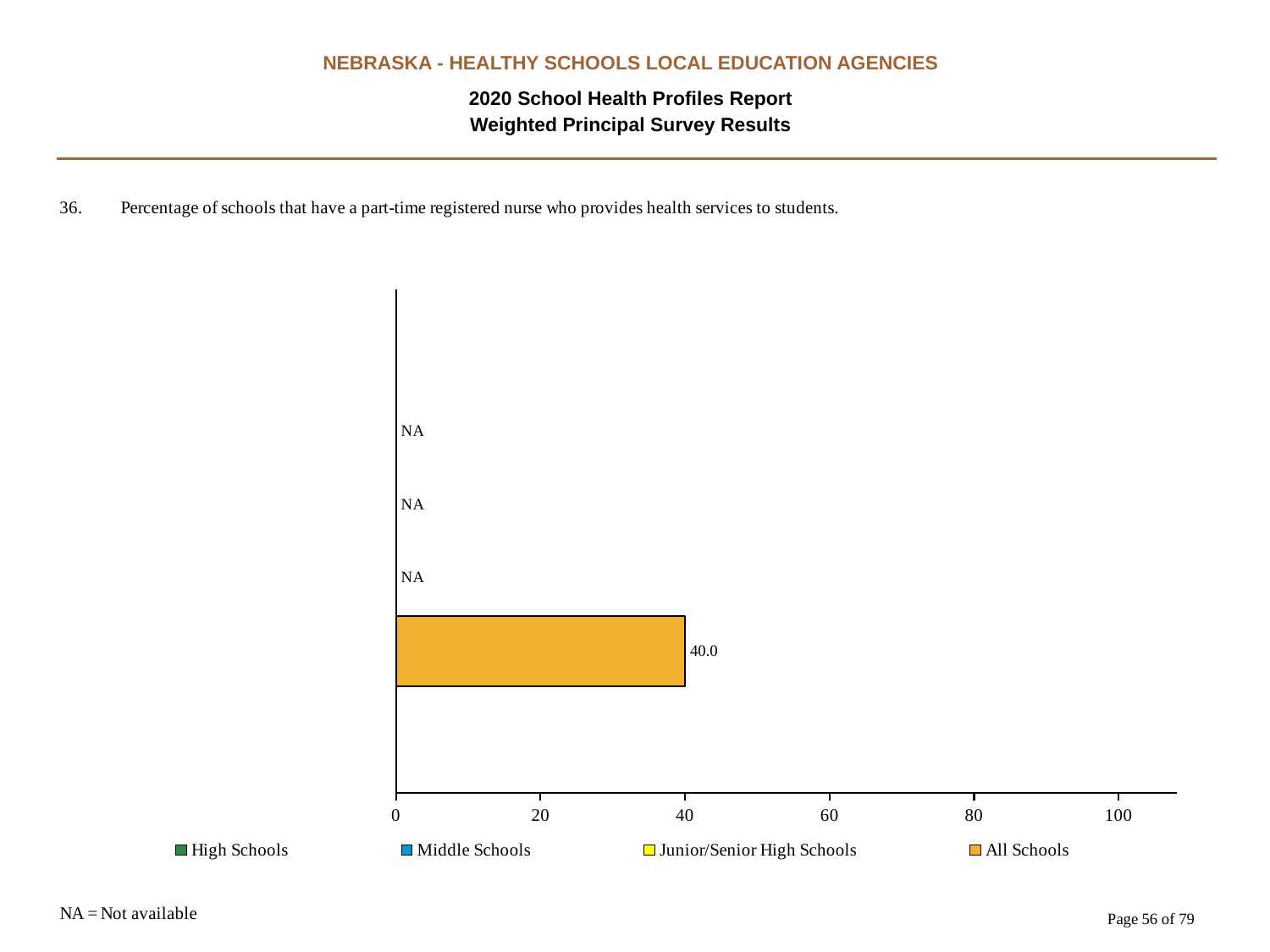
What is the highest value shown on the x axis? 100 What is the value for All Schools? 40.0 Which series has the only plotted bar? All Schools How many series does the legend list? 4 What kind of chart is this? Bar chart Is the value for All Schools greater or less than 20? greater Is the value for All Schools greater or less than 60? less How many series have a plotted bar with a numeric value? 1 What is shown for Middle Schools? NA What is shown for Junior/Senior High Schools? NA What is shown for High Schools? NA What does NA stand for according to the note on the slide? Not available